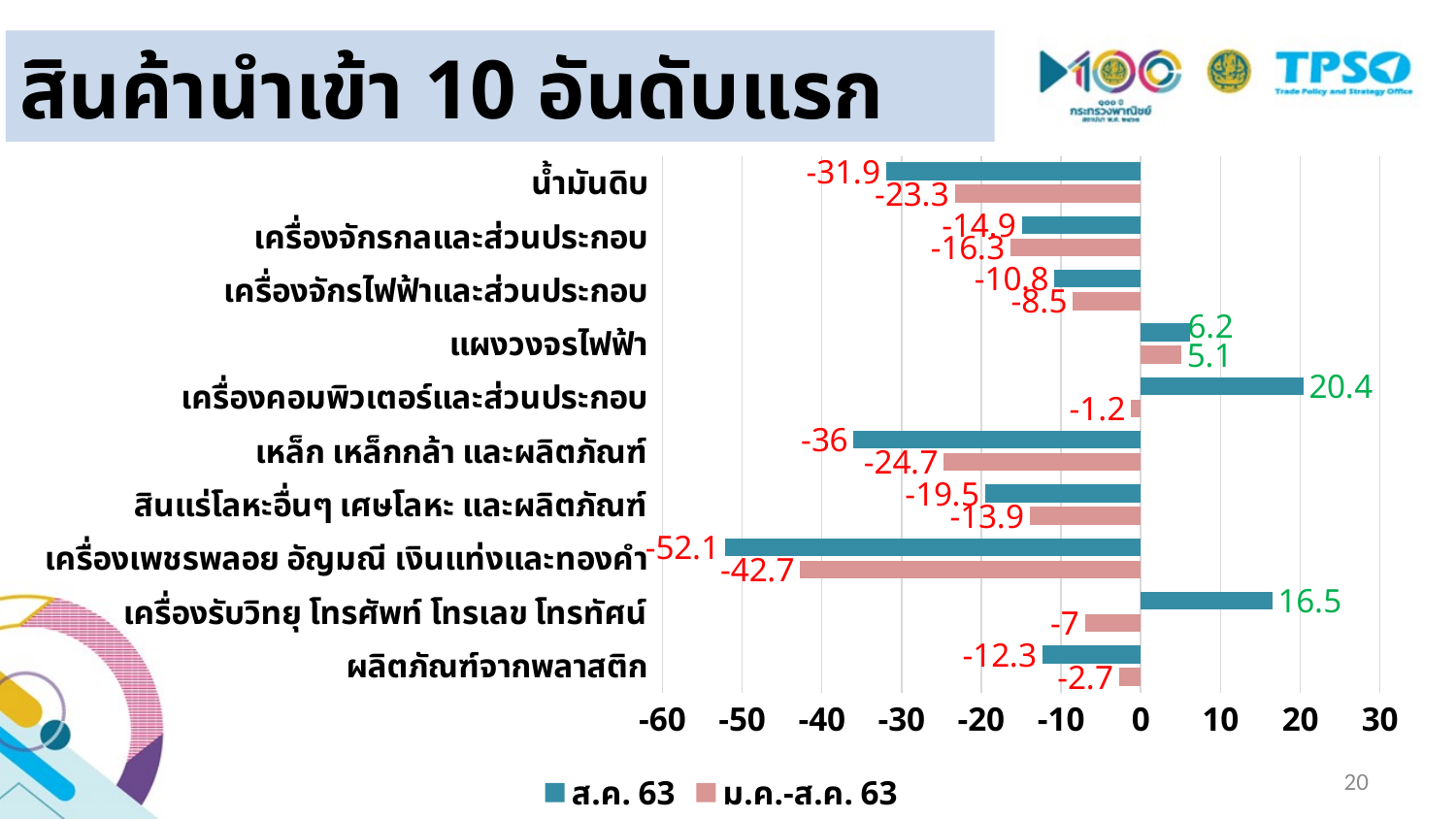
Which category has the lowest ม.ค.-ส.ค. 63 value? เครื่องเพชรพลอย อัญมณี เงินแท่งและทองคำ What is the difference between the ส.ค. 63 and ม.ค.-ส.ค. 63 values for เหล็ก เหล็กกล้า และผลิตภัณฑ์? 11.3 What kind of chart is shown on the slide? bar chart What is the ส.ค. 63 value for น้ำมันดิบ? -31.9 How many categories are shown in the chart? 10 What is the title of the slide? สินค้านำเข้า 10 อันดับแรก What is the ส.ค. 63 value for เครื่องรับวิทยุ โทรศัพท์ โทรเลข โทรทัศน์? 16.5 Is the ส.ค. 63 value for เครื่องเพชรพลอย อัญมณี เงินแท่งและทองคำ greater or less than -50? less How many series does the legend list? 2 Which category has the highest ส.ค. 63 value? เครื่องคอมพิวเตอร์และส่วนประกอบ Which is larger for เครื่องจักรกลและส่วนประกอบ: the ส.ค. 63 value or the ม.ค.-ส.ค. 63 value? ส.ค. 63 What is the ม.ค.-ส.ค. 63 value for เครื่องคอมพิวเตอร์และส่วนประกอบ? -1.2